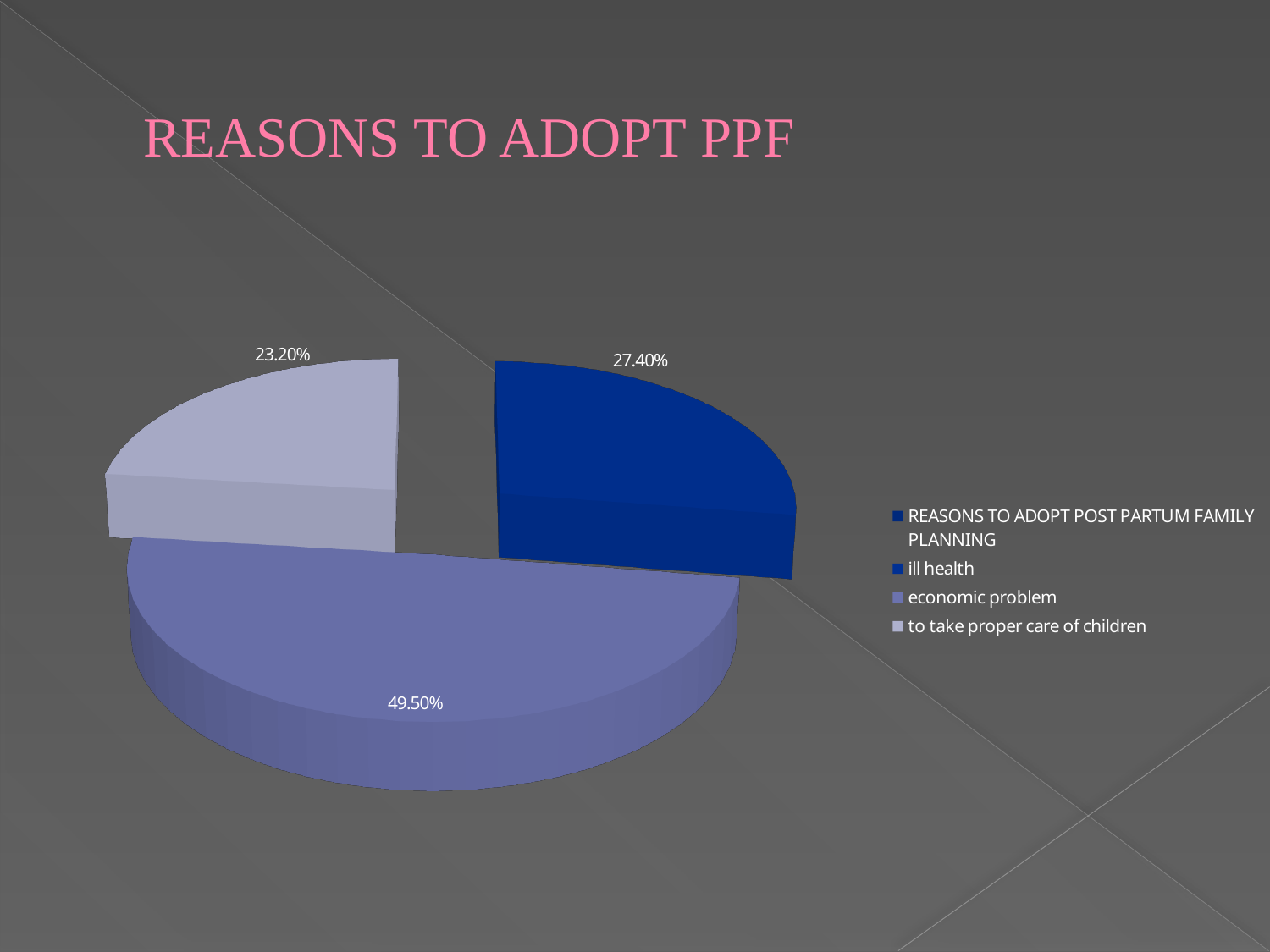
Which reason has the largest share of the pie? economic problem What is the value of the largest slice in the pie chart? 49.50% What percentage is shown for to take proper care of children? 23.20% What is the difference between the 49.50% slice and the 23.20% slice? 26.30% How many entries does the legend list? 4 What is the title of the slide's chart? REASONS TO ADOPT PPF Which is larger, the share for economic problem or the share for to take proper care of children? economic problem What kind of chart is shown on the slide? pie chart What percentage is shown for economic problem? 49.50% How many slices with data labels does the pie chart have? 3 What is the difference between the 49.50% slice and the 27.40% slice? 22.10% What is the value of the smallest slice in the pie chart? 23.20%